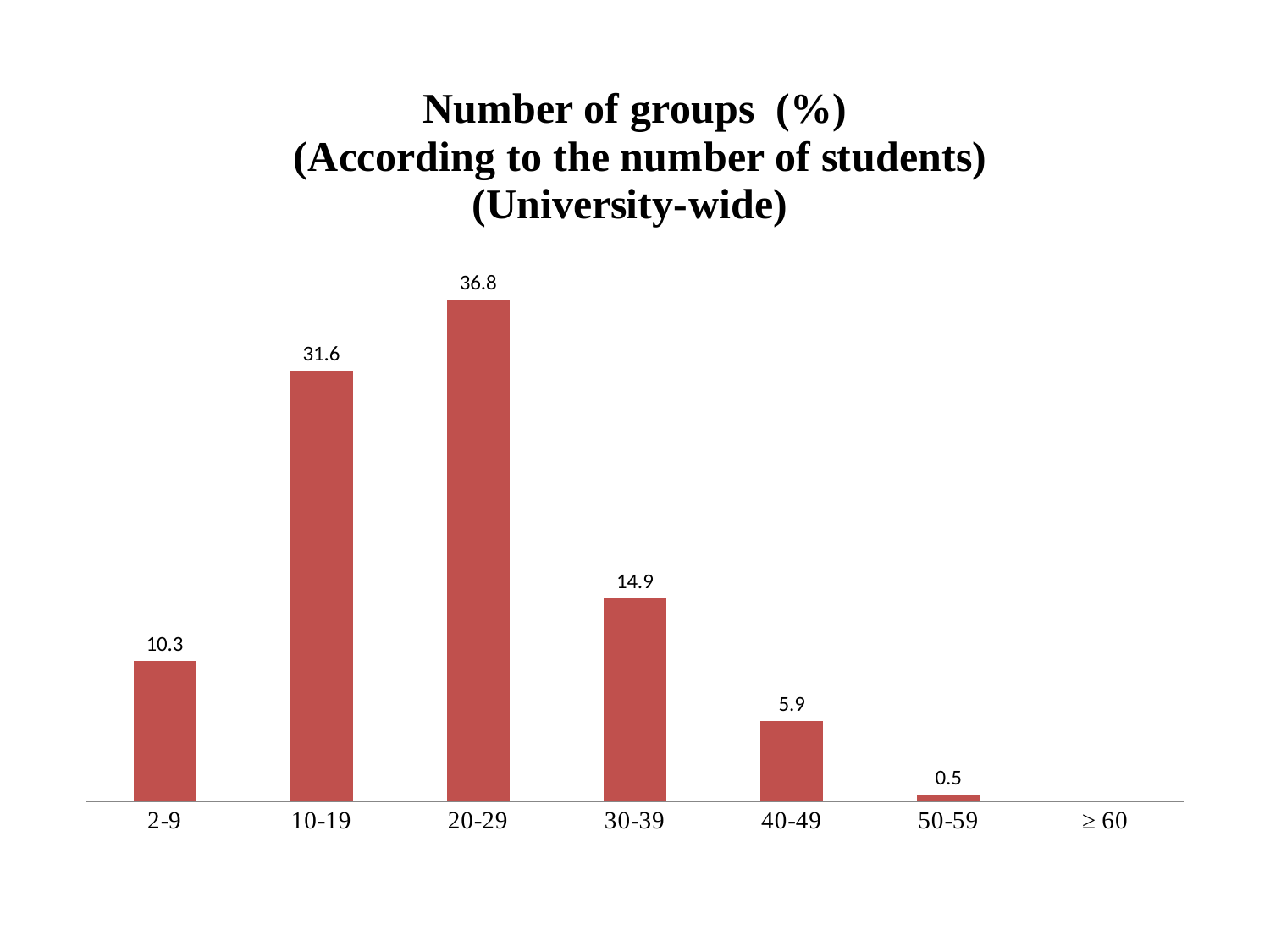
What kind of chart is shown on the slide? Bar chart What is the difference between the values for 20-29 and 10-19? 5.2 Which is larger, the value for 2-9 or the value for 30-39? 30-39 What is the value shown for the 40-49 category? 5.9 What is the difference between the values for 30-39 and 40-49? 9.0 Which category has the highest value? 20-29 What percentage of groups have 20-29 students? 36.8 What is the value shown for the 50-59 category? 0.5 Do the values rise or fall from the 20-29 category to the 50-59 category? Fall What is the value shown for the 2-9 category? 10.3 How many categories are shown on the x axis? 7 What is the first line of the chart title? Number of groups (%)